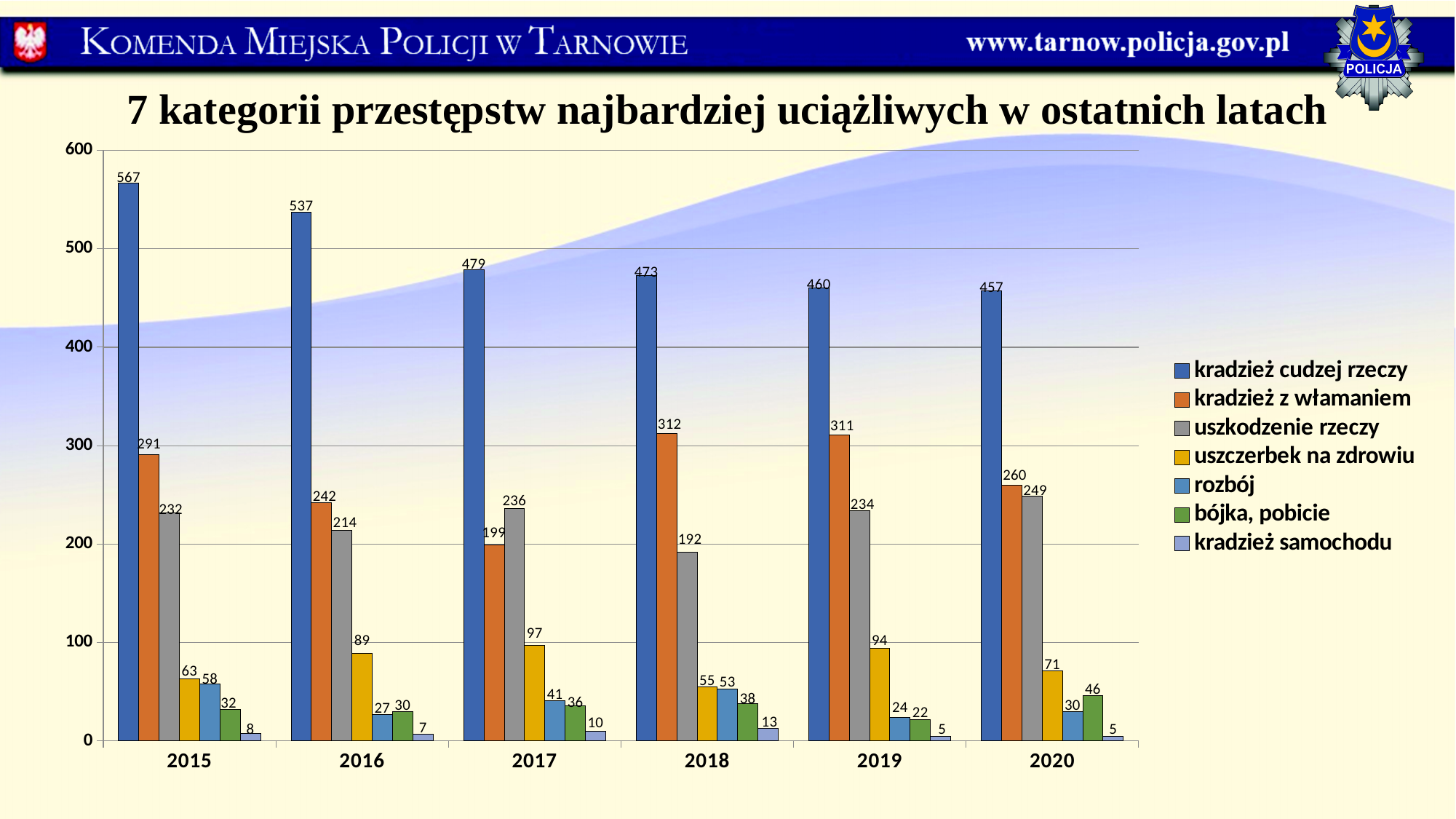
What is the value for kradzież cudzej rzeczy in 2015? 567 In which year is kradzież z włamaniem the highest? 2018 What type of chart is shown on the slide? bar chart How many series does the legend list? 7 Which is larger in 2016: uszkodzenie rzeczy or kradzież z włamaniem? kradzież z włamaniem What is the difference between kradzież cudzej rzeczy in 2015 and in 2020? 110 How many years are shown on the x axis? 6 In which year is kradzież cudzej rzeczy the lowest? 2020 What is the value for uszczerbek na zdrowiu in 2017? 97 What is the value for kradzież z włamaniem in 2018? 312 What is the value for kradzież samochodu in 2020? 5 Does the value for kradzież cudzej rzeczy rise or fall from 2015 to 2020? fall